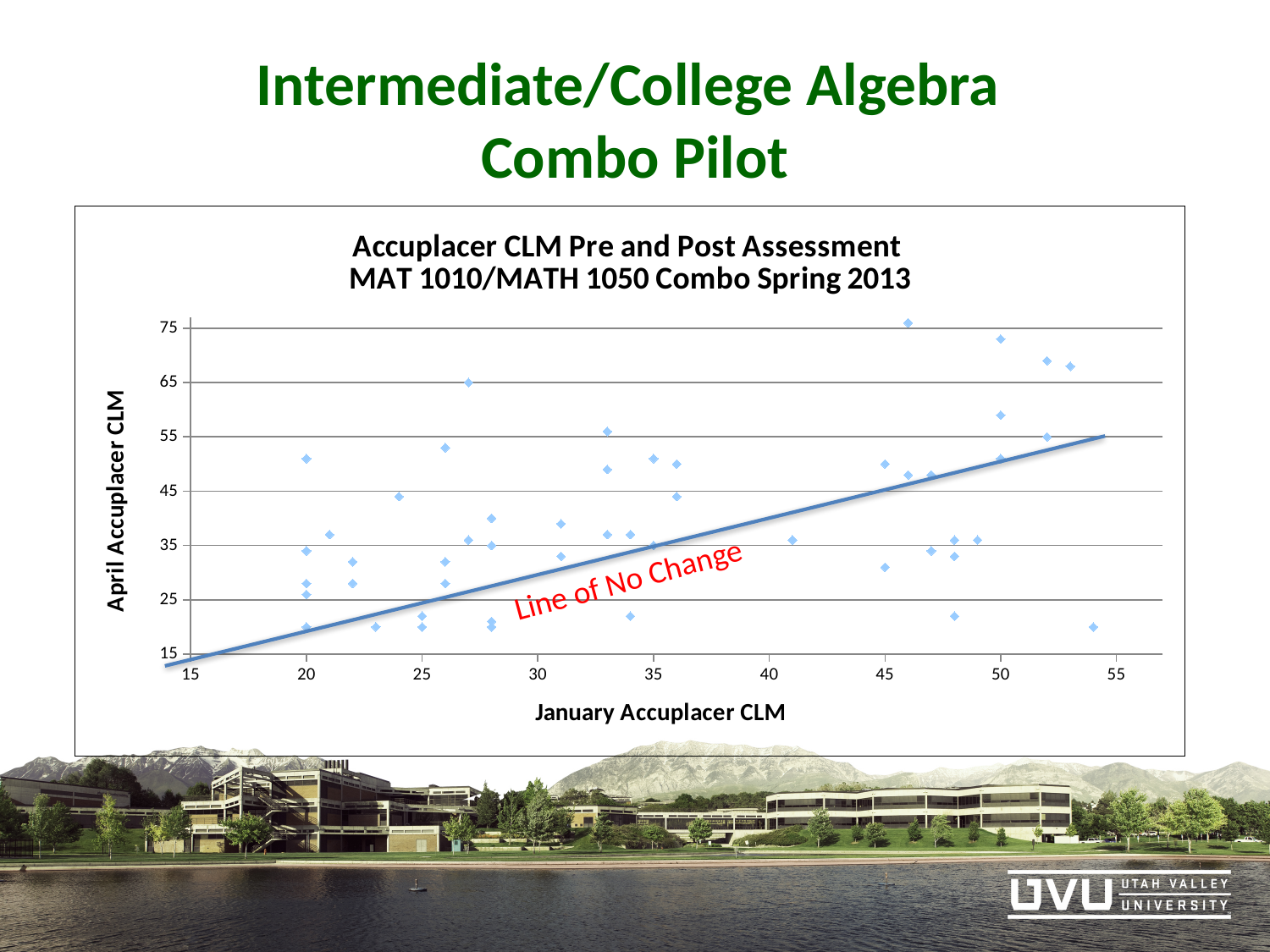
Do the April Accuplacer CLM scores generally rise or fall as the January Accuplacer CLM scores increase? rise What is the title of the chart? Accuplacer CLM Pre and Post Assessment MAT 1010/MATH 1050 Combo Spring 2013 What kind of chart is shown on the slide? scatter chart What label is written along the diagonal line in the chart? Line of No Change Is the lowest April Accuplacer CLM value plotted greater or less than 25? less Is the highest April Accuplacer CLM value plotted greater or less than 65? greater Is the April Accuplacer CLM value of the point plotted at a January score of 27 that lies above the 55 gridline greater or less than 55? greater